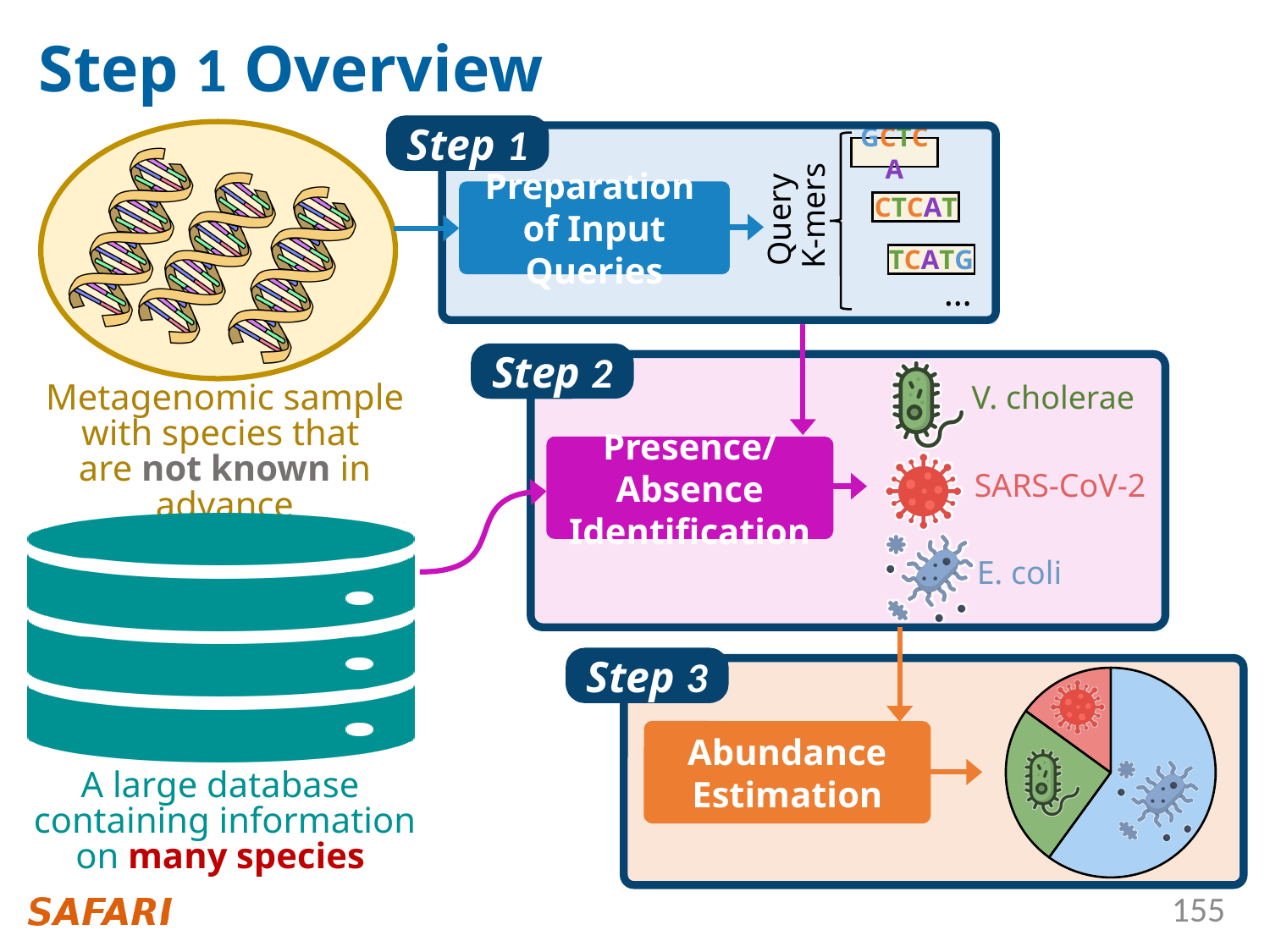
How many slices does the pie chart in the Step 3 box have? 3 What kind of chart is shown in the Step 3 box? pie chart In the Step 3 pie chart, which colour slice is the largest? blue